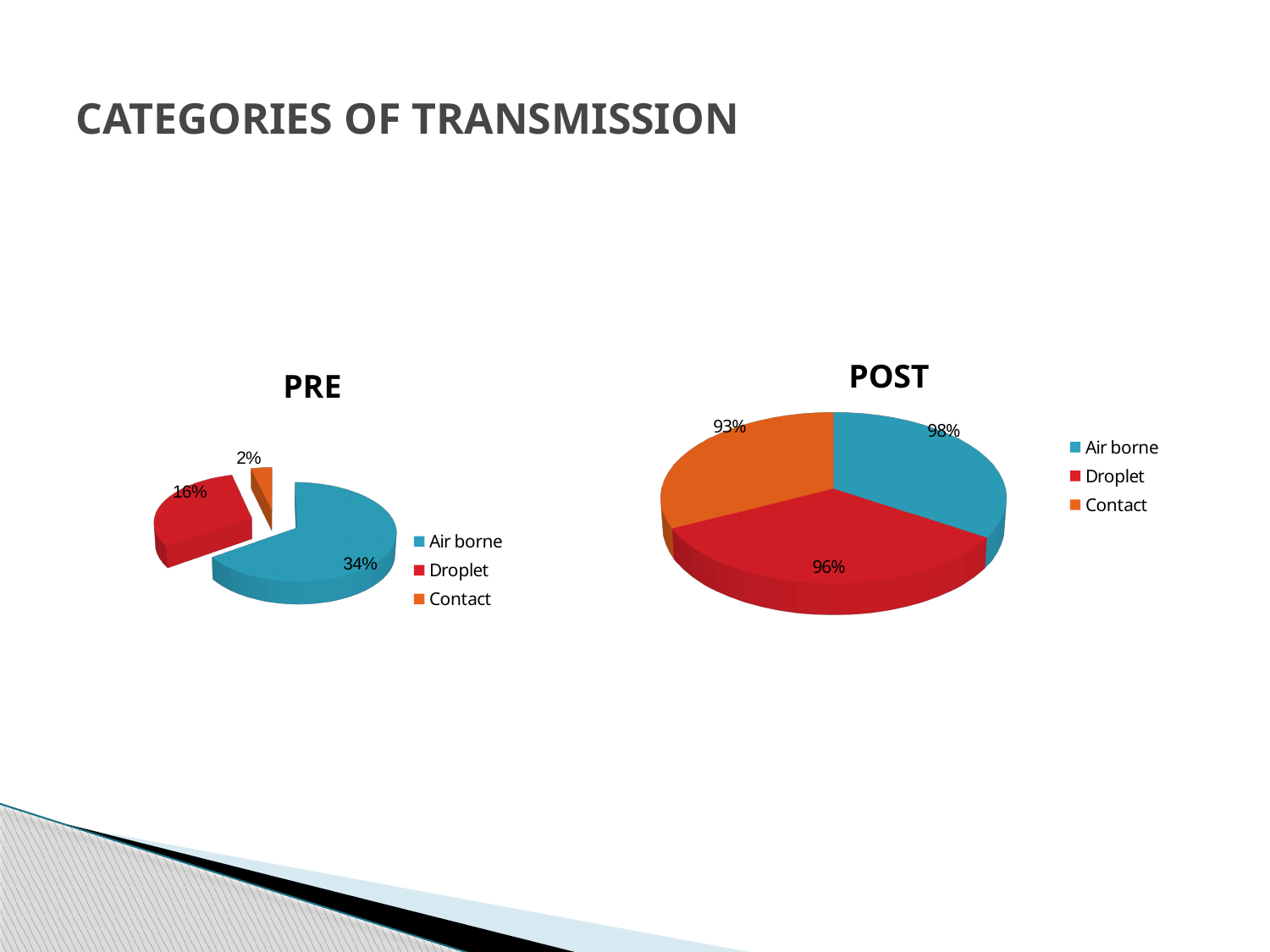
In the POST chart, what value is shown for Droplet? 96% What is the difference between the Air borne values in the POST chart and the PRE chart? 64% In the POST chart, which category has the lowest value? Contact How many categories does the legend of the POST chart list? 3 What type of chart is the PRE chart? Pie chart In the POST chart, what value is shown for Contact? 93% In the PRE chart, what value is shown for Contact? 2% In the POST chart, what value is shown for Air borne? 98% In the PRE chart, what value is shown for Air borne? 34% In the PRE chart, which category has the lowest value? Contact In the PRE chart, what value is shown for Droplet? 16% In the PRE chart, which category has the highest value? Air borne